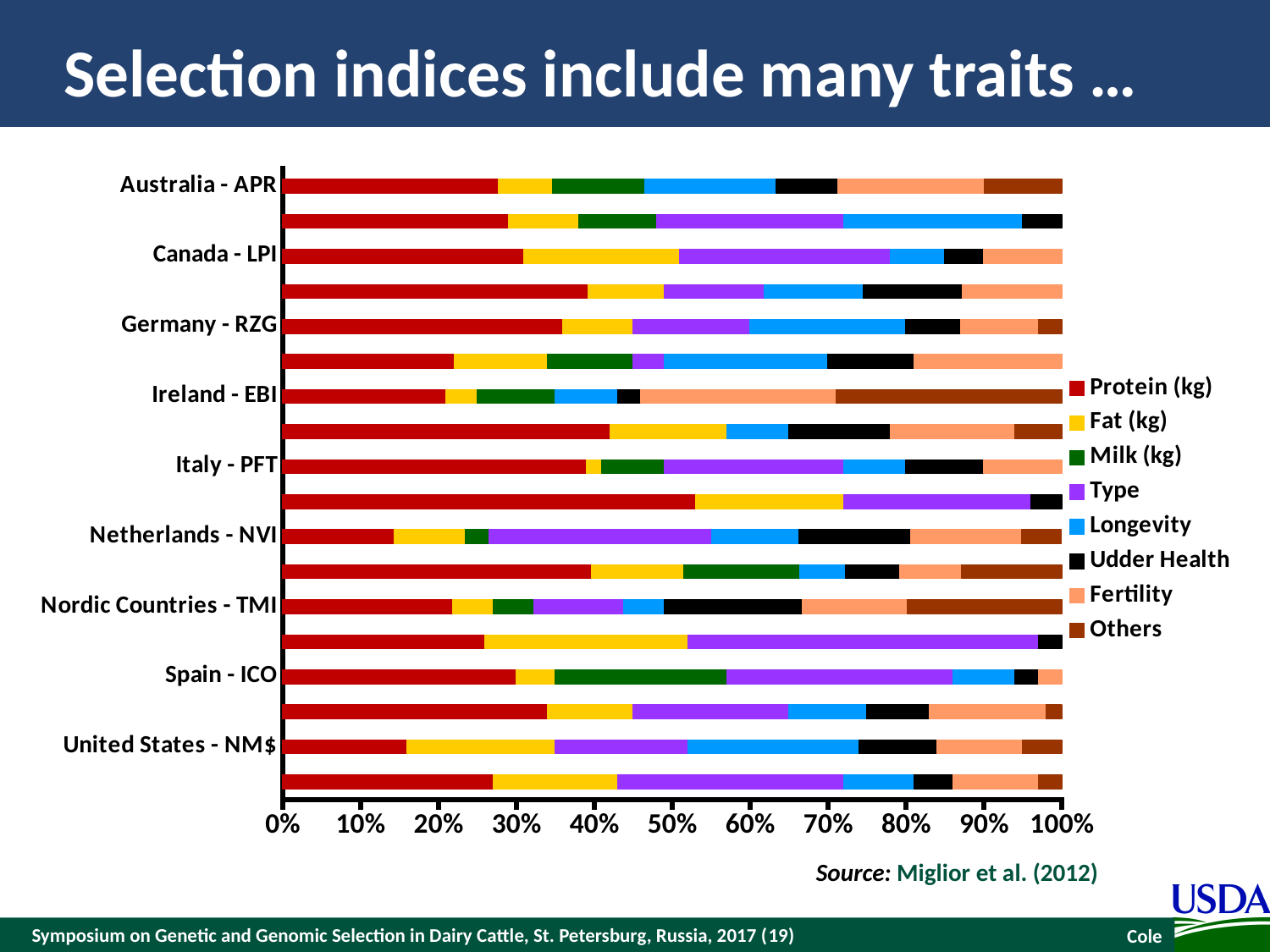
Is the Protein (kg) share for Nordic Countries - TMI greater or less than 30%? less Is the Protein (kg) share for Australia - APR greater or less than 30%? less What colour represents Protein (kg) in the chart? Red Is the Protein (kg) share for Netherlands - NVI greater or less than 20%? less How many series does the legend list? 8 What kind of chart is shown on the slide? Stacked bar chart Which has the larger Protein (kg) share, Netherlands - NVI or Italy - PFT? Italy - PFT Which has the larger Others share, Ireland - EBI or Australia - APR? Ireland - EBI Which series is listed first in the legend? Protein (kg)